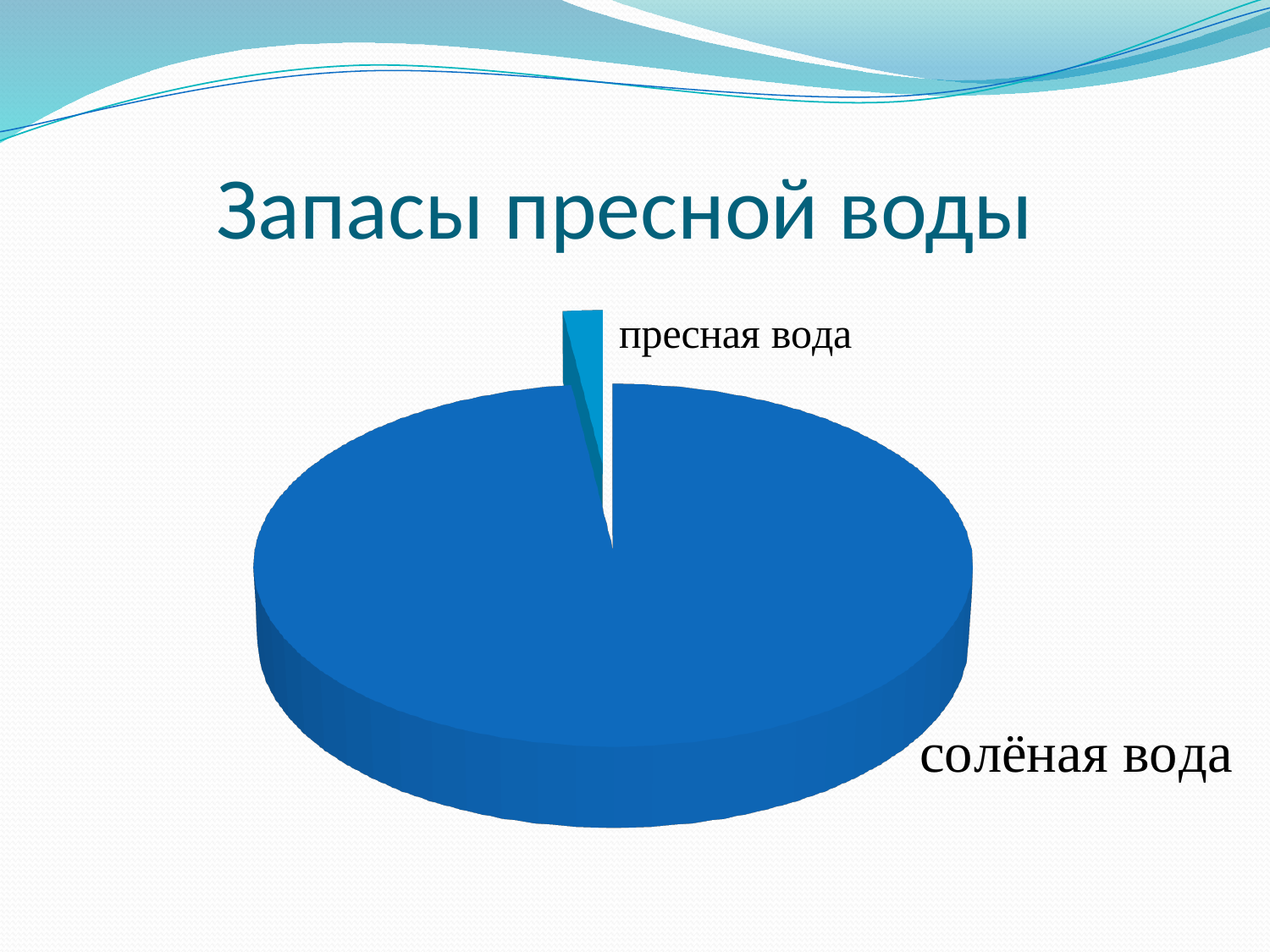
Which slice is larger, пресная вода or солёная вода? солёная вода What is the title of the slide above the pie chart? Запасы пресной воды Which slice of the pie chart is the largest? солёная вода Which slice of the pie chart is the smallest? пресная вода What are the labels of the two slices in the pie chart? пресная вода, солёная вода What kind of chart is shown on the slide? pie chart How many slices does the pie chart have? 2